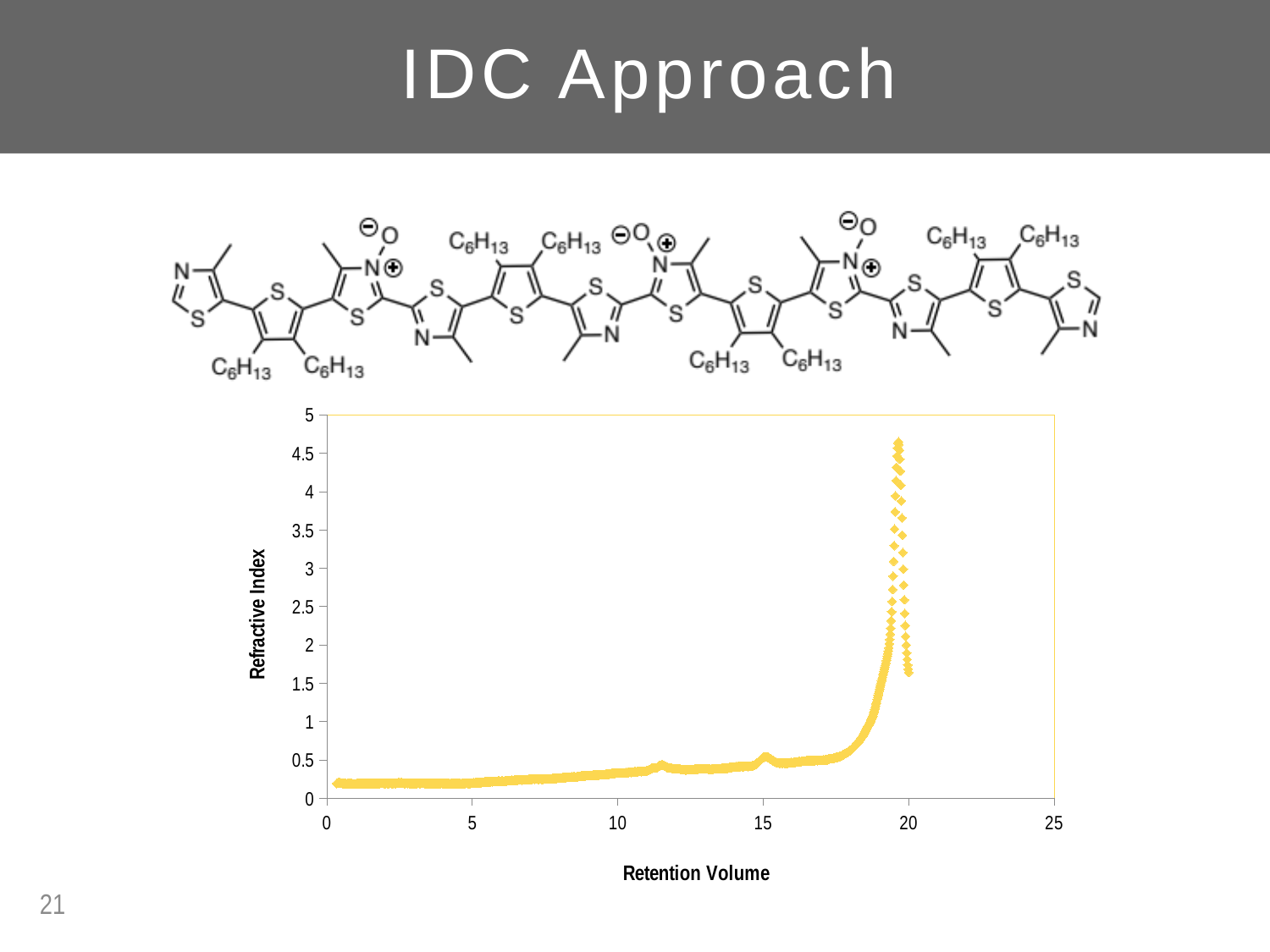
What kind of chart is shown on the slide? scatter chart Is the refractive index at a retention volume of 15 greater or less than 1? less Is the highest refractive index value plotted greater or less than 4? greater Is the retention volume at which the refractive index peaks greater or less than 15? greater Do the refractive index values generally rise or fall as retention volume increases from 0 to 20? rise What is the maximum value shown on the x axis of the chart? 25 What is the label of the x axis of the chart? Retention Volume What is the label of the y axis of the chart? Refractive Index Which is larger, the refractive index at a retention volume of 5 or at a retention volume of 19.5? 19.5